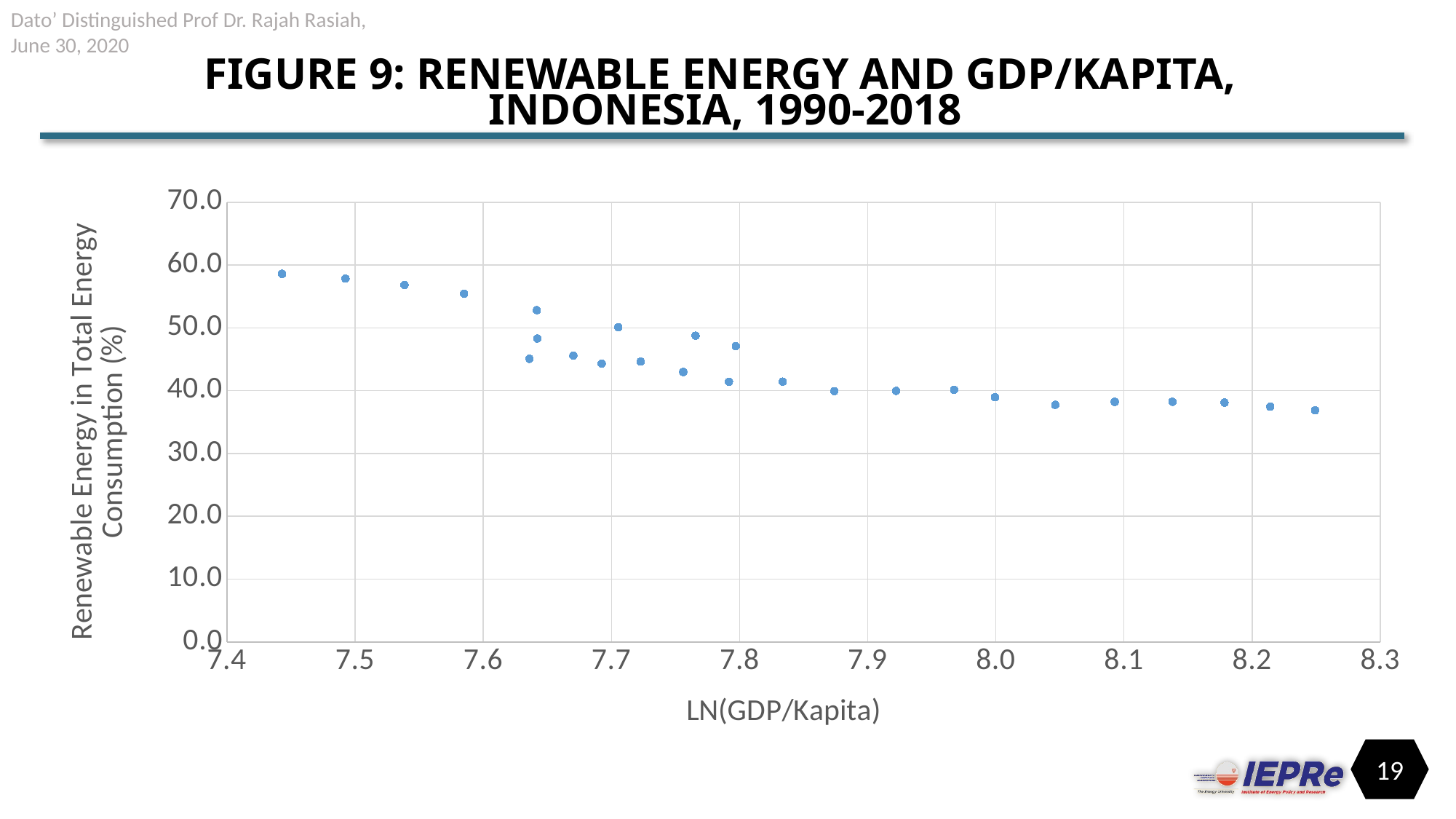
What kind of chart is shown on the slide? Scatter chart Which has the higher renewable energy share: the point at LN(GDP/Kapita) of about 7.45 or the point at about 8.25? The point at about 7.45 Is the renewable energy value for the leftmost point (around LN(GDP/Kapita) 7.45) greater or less than 50.0? greater What is the label of the x axis? LN(GDP/Kapita) Is the renewable energy value for the rightmost point (around LN(GDP/Kapita) 8.25) greater or less than 40.0? less Does the point with the highest renewable energy share lie at the low end or the high end of the LN(GDP/Kapita) axis? Low end Is the renewable energy value for the point at LN(GDP/Kapita) of about 7.54 greater or less than 60.0? less What is the title of the chart? Figure 9: Renewable Energy and GDP/Kapita, Indonesia, 1990-2018 What is the maximum value shown on the y axis? 70.0 As LN(GDP/Kapita) increases along the x axis, do the renewable energy values generally rise or fall? Fall